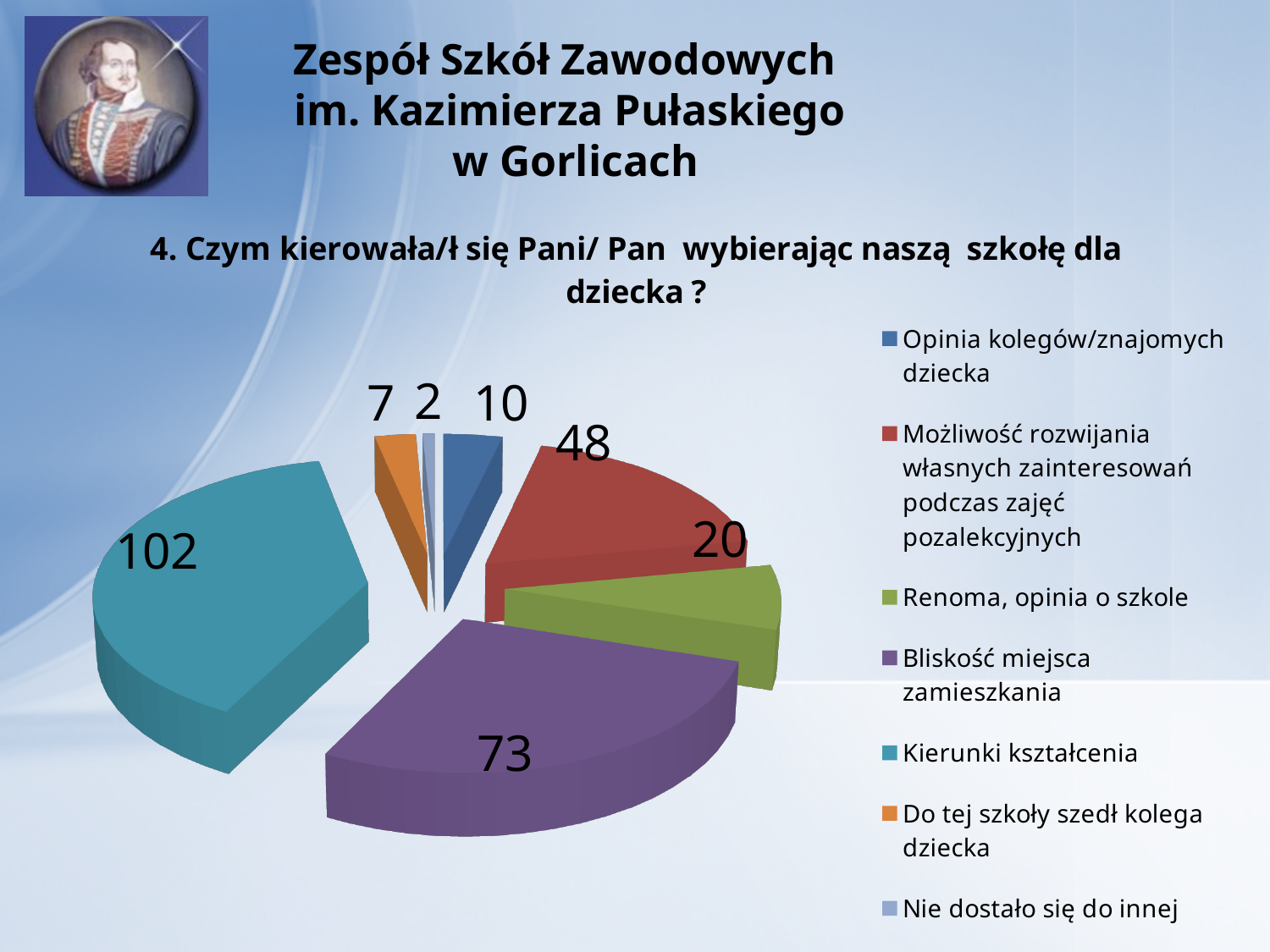
What is the value for "Renoma, opinia o szkole"? 20 Which category has the largest slice? Kierunki kształcenia Which category has the smallest slice? Nie dostało się do innej What is the total of all slices in the pie chart? 262 What is the value for "Kierunki kształcenia"? 102 What is the value for "Bliskość miejsca zamieszkania"? 73 How many slices does the pie chart have? 7 Which is larger: "Możliwość rozwijania własnych zainteresowań podczas zajęć pozalekcyjnych" or "Renoma, opinia o szkole"? Możliwość rozwijania własnych zainteresowań podczas zajęć pozalekcyjnych What is the value for "Nie dostało się do innej"? 2 What is the difference between the values for "Kierunki kształcenia" and "Bliskość miejsca zamieszkania"? 29 What colour is the slice for "Bliskość miejsca zamieszkania"? purple What kind of chart is shown on the slide? pie chart